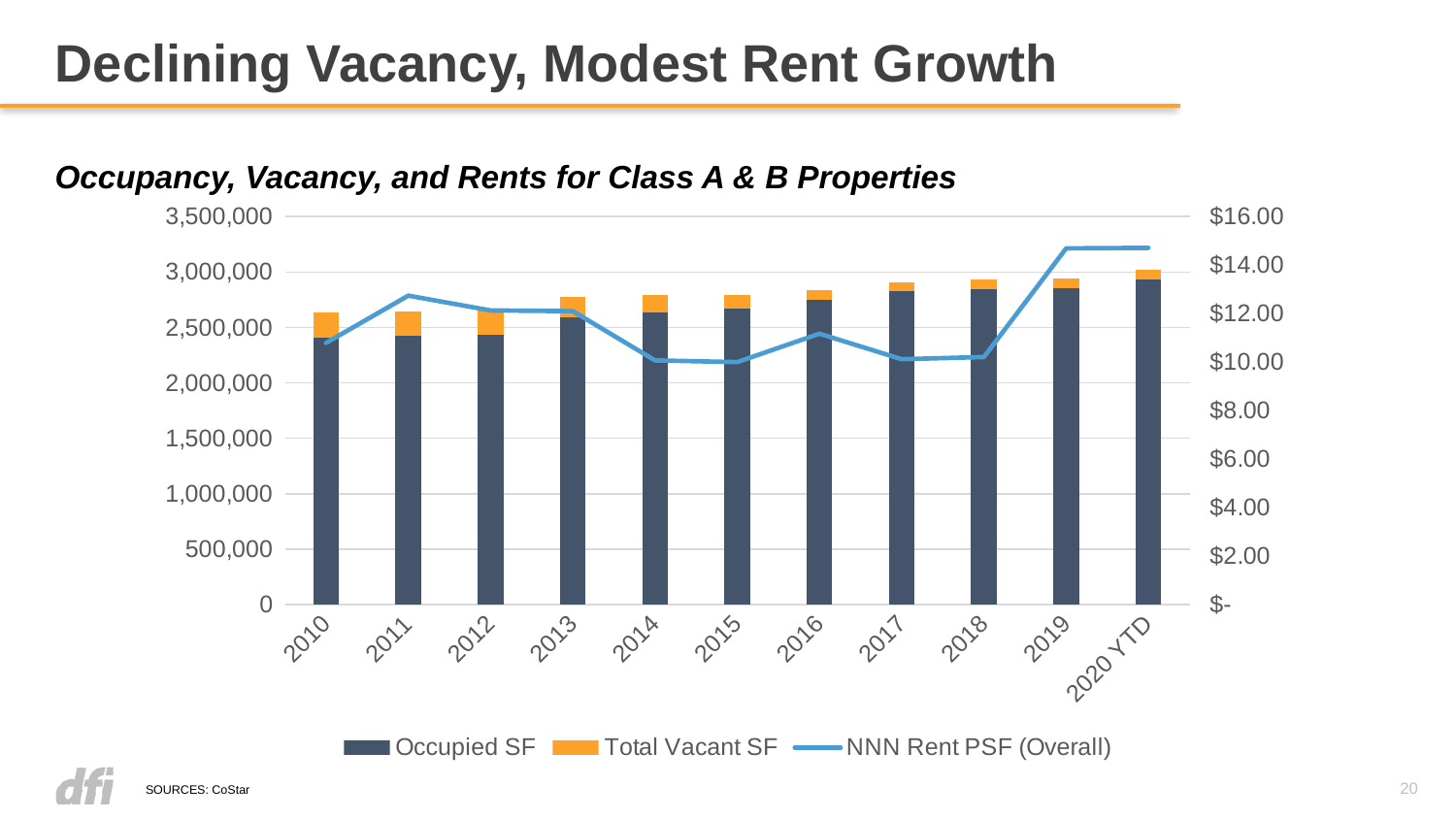
Is the Occupied SF for 2020 YTD greater or less than 2,500,000? greater Is the Occupied SF for 2010 greater or less than 2,500,000? less What kind of chart is shown on the slide? A combination chart with stacked bars and a line How many years (categories) are shown on the x axis? 11 How many series does the legend list? 3 Which year has the higher NNN Rent PSF (Overall), 2011 or 2014? 2011 What is the title of the chart? Occupancy, Vacancy, and Rents for Class A & B Properties Is the NNN Rent PSF (Overall) for 2019 greater or less than $14.00? greater Which year has the highest Occupied SF? 2020 YTD Does Occupied SF generally rise or fall from 2010 to 2020 YTD? rise